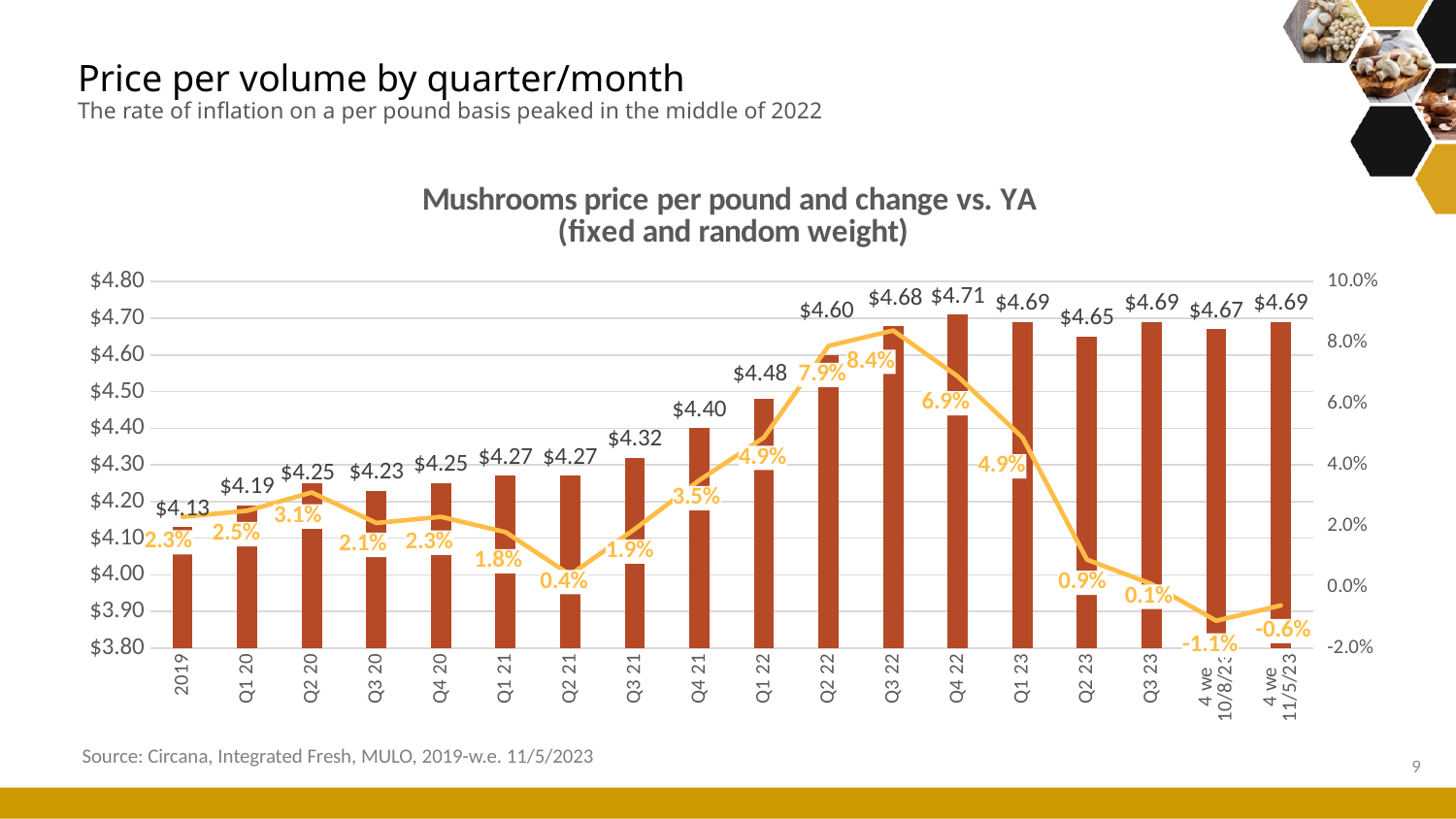
What is the difference in price per pound between Q4 22 and 2019? $0.58 Which has the higher price per pound, Q4 21 or Q1 22? Q1 22 What is the price per pound for the 4 weeks ending 11/5/23? $4.69 What is the mushrooms price per pound for Q4 22? $4.71 What is the change vs. YA shown for Q2 21? 0.4% What is the change vs. YA shown for Q3 22? 8.4% In which period is the change vs. YA lowest? 4 we 10/8/23 What kind of chart is this? Combined bar and line chart Which period has the highest price per pound? Q4 22 Which period has the lowest price per pound? 2019 How many periods are shown on the x axis? 18 In which period is the change vs. YA highest? Q3 22